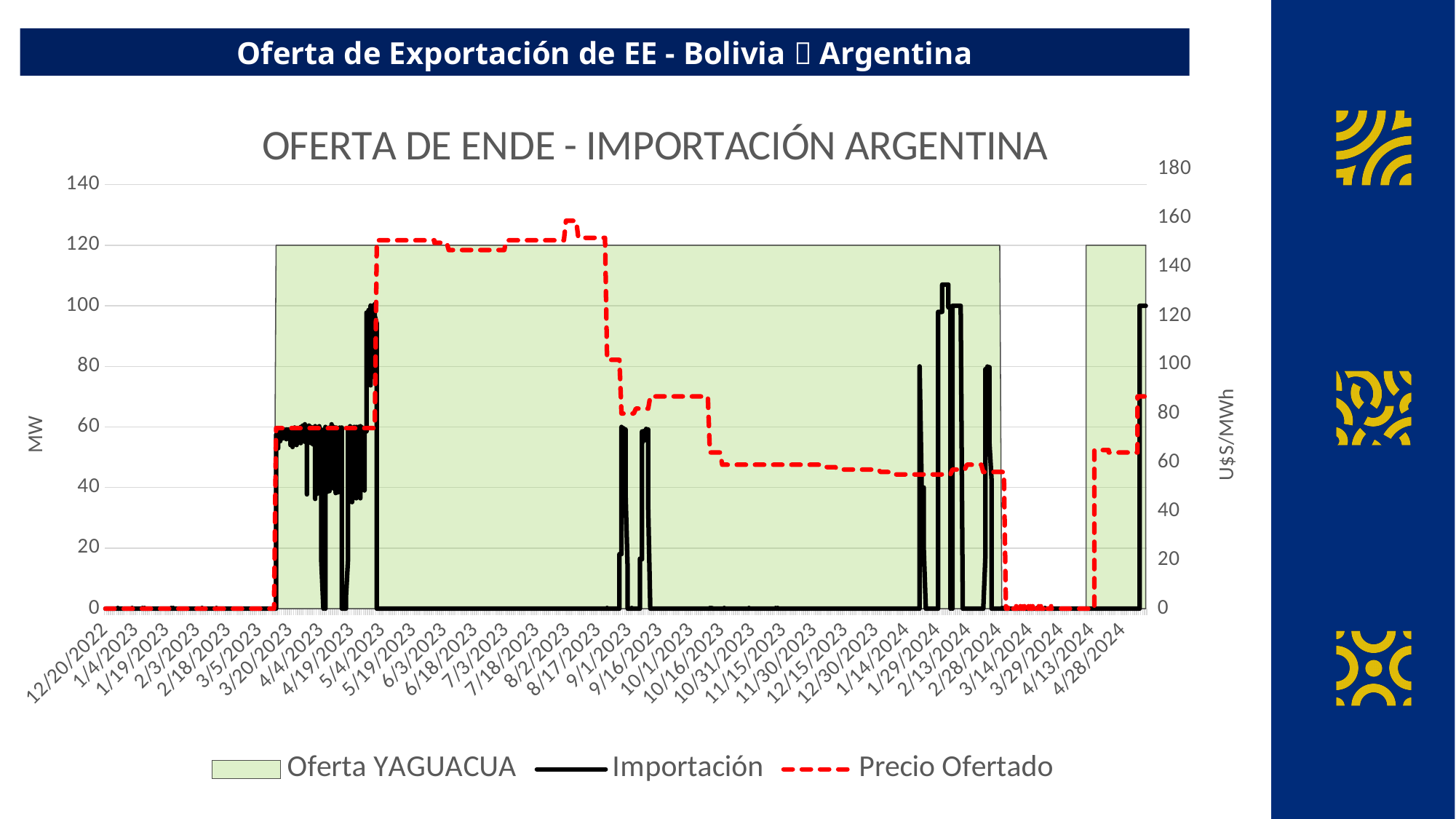
Is the Precio Ofertado value around 11/15/2023 greater or less than 80? less Which series is drawn as a red dashed line? Precio Ofertado What kind of chart is shown on the slide? line chart with a shaded area series Is the top of the Oferta YAGUACUA shaded area greater or less than 100 MW? greater Which is larger: the Precio Ofertado value around 6/3/2023 or around 11/15/2023? 6/3/2023 Is the Precio Ofertado value around 3/29/2024 greater or less than 20? less What is the value of Importación on 12/20/2022? 0 Does the Precio Ofertado series rise or fall between 6/3/2023 and 11/15/2023? fall What is the title of the chart? OFERTA DE ENDE - IMPORTACIÓN ARGENTINA How many series does the chart legend list? 3